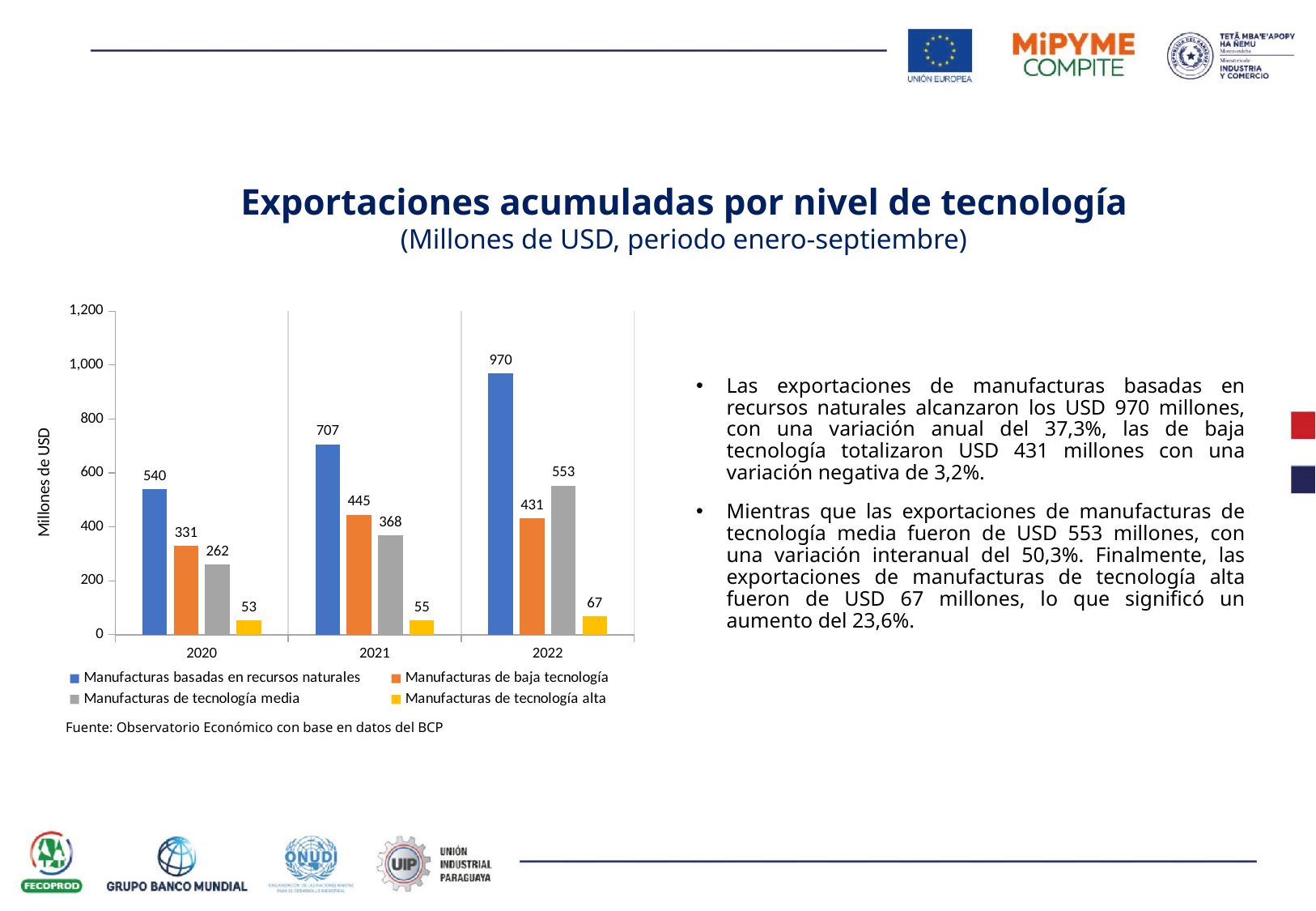
How many series does the legend list? 4 Which series has the lowest value in 2021? Manufacturas de tecnología alta What is the value for Manufacturas de tecnología media in 2021? 368 What is the label of the y axis? Millones de USD What is the value for Manufacturas de tecnología alta in 2020? 53 Which is larger in 2022: Manufacturas de baja tecnología or Manufacturas de tecnología media? Manufacturas de tecnología media What kind of chart is shown on the slide? Bar chart What is the difference between Manufacturas basadas en recursos naturales in 2022 and in 2021? 263 Which year has the highest value for Manufacturas basadas en recursos naturales? 2022 Do the values for Manufacturas de tecnología media rise or fall from 2020 to 2022? Rise How many years are shown on the x axis? 3 What is the value for Manufacturas basadas en recursos naturales in 2022? 970